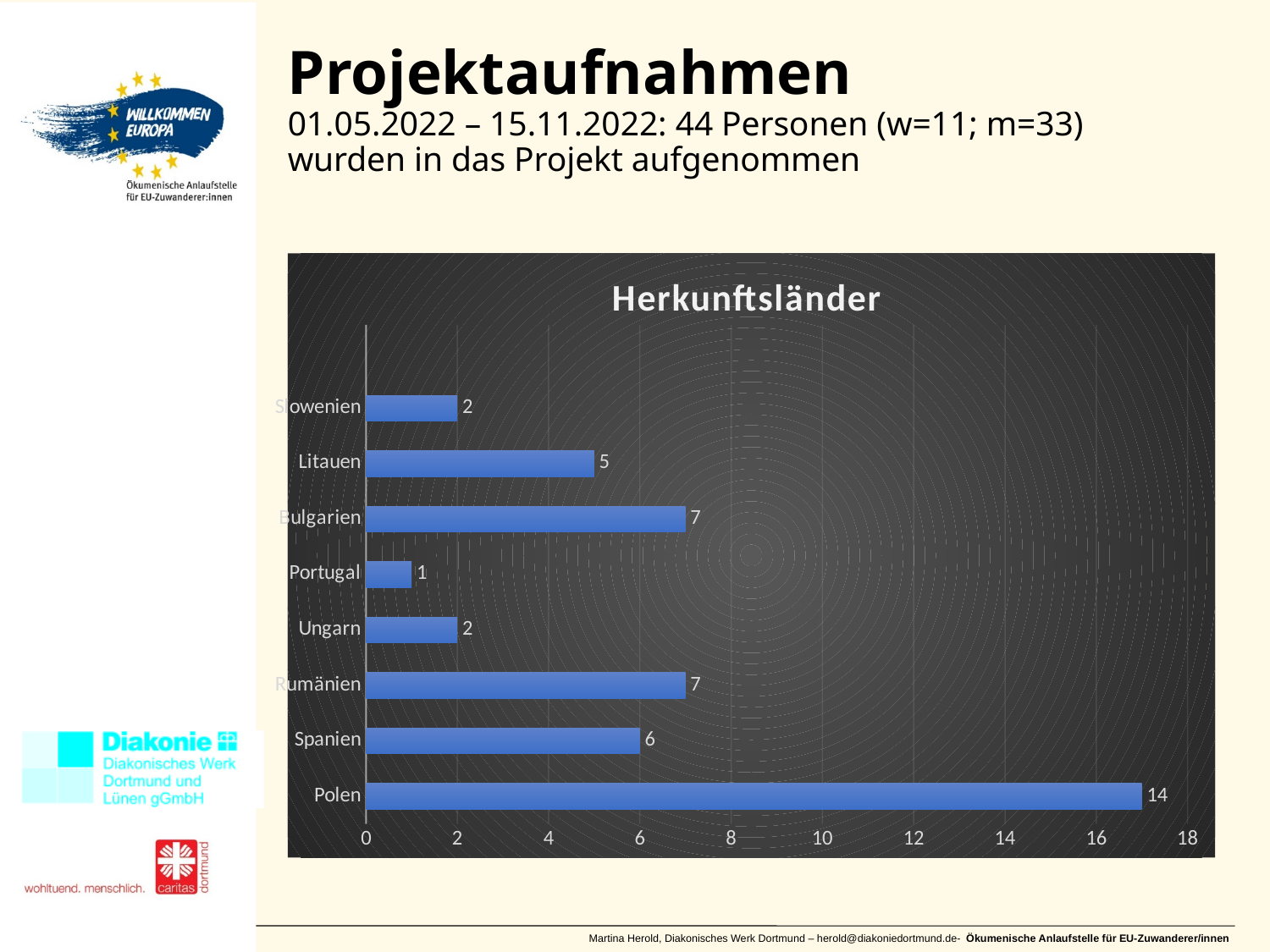
Which has a larger value, Spanien or Litauen? Spanien What is the value for Litauen? 5 What kind of chart is shown on the slide? bar chart Which country has the highest value? Polen How many countries are listed in the chart? 8 Is the value for Rumänien greater or less than 4? greater What is the title of the chart? Herkunftsländer What is the value for Spanien? 6 What is the value for Polen? 14 What is the difference between the values for Bulgarien and Ungarn? 5 What is the value for Portugal? 1 Which country has the lowest value? Portugal